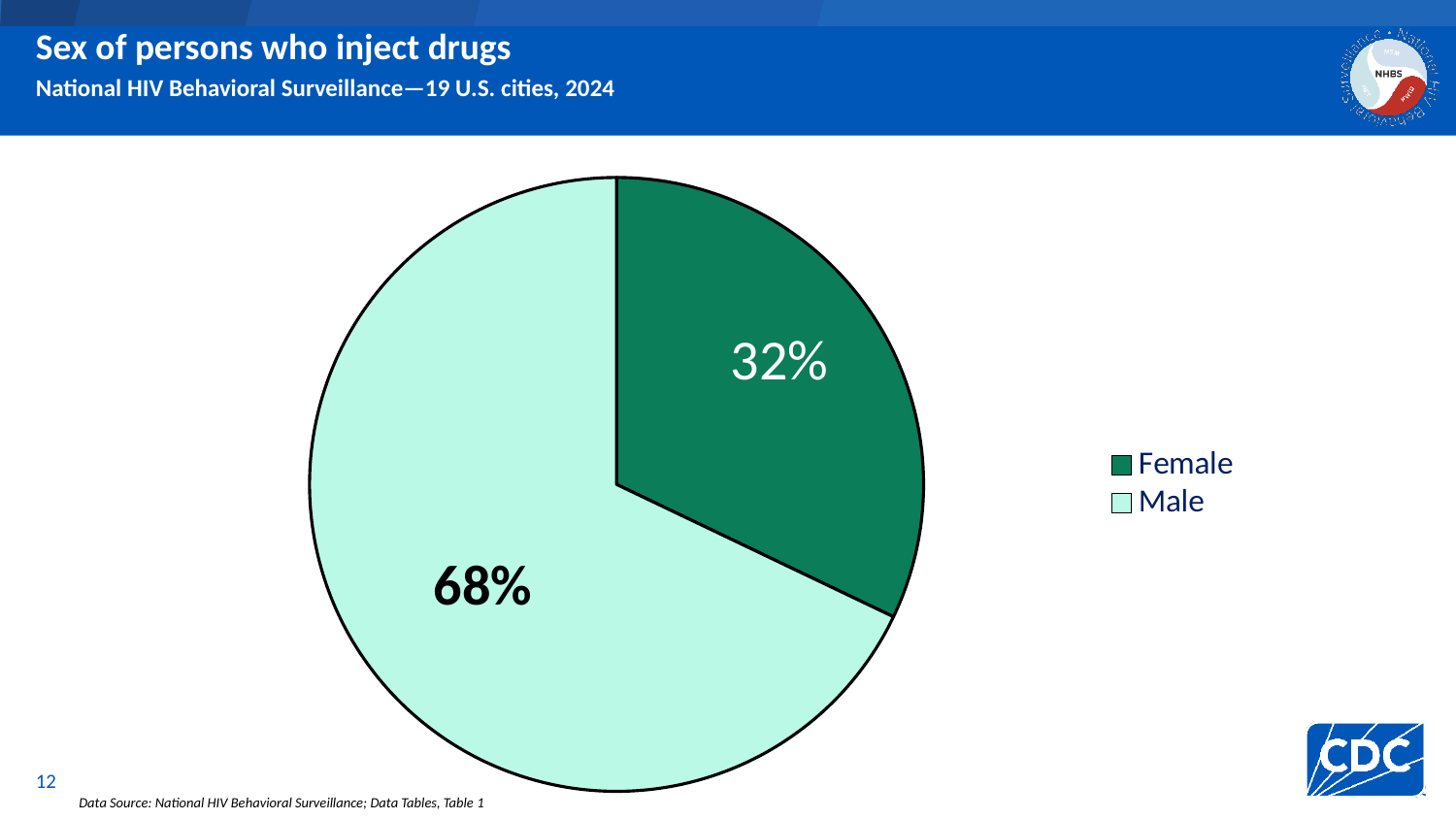
Which sex category has the smallest share of the pie? Female What percentage of persons who inject drugs are female? 32% Which category is shown in the darker green colour in the legend? Female What is the difference in percentage points between the male and female shares? 36 What share of the pie does the Male slice represent? 68% What percentage of persons who inject drugs are male? 68% Which is larger, the share of males or the share of females? Male What is the title of the chart? Sex of persons who inject drugs What kind of chart is shown on the slide? Pie chart How many categories are shown in the pie chart? 2 Which sex category has the largest share of the pie? Male